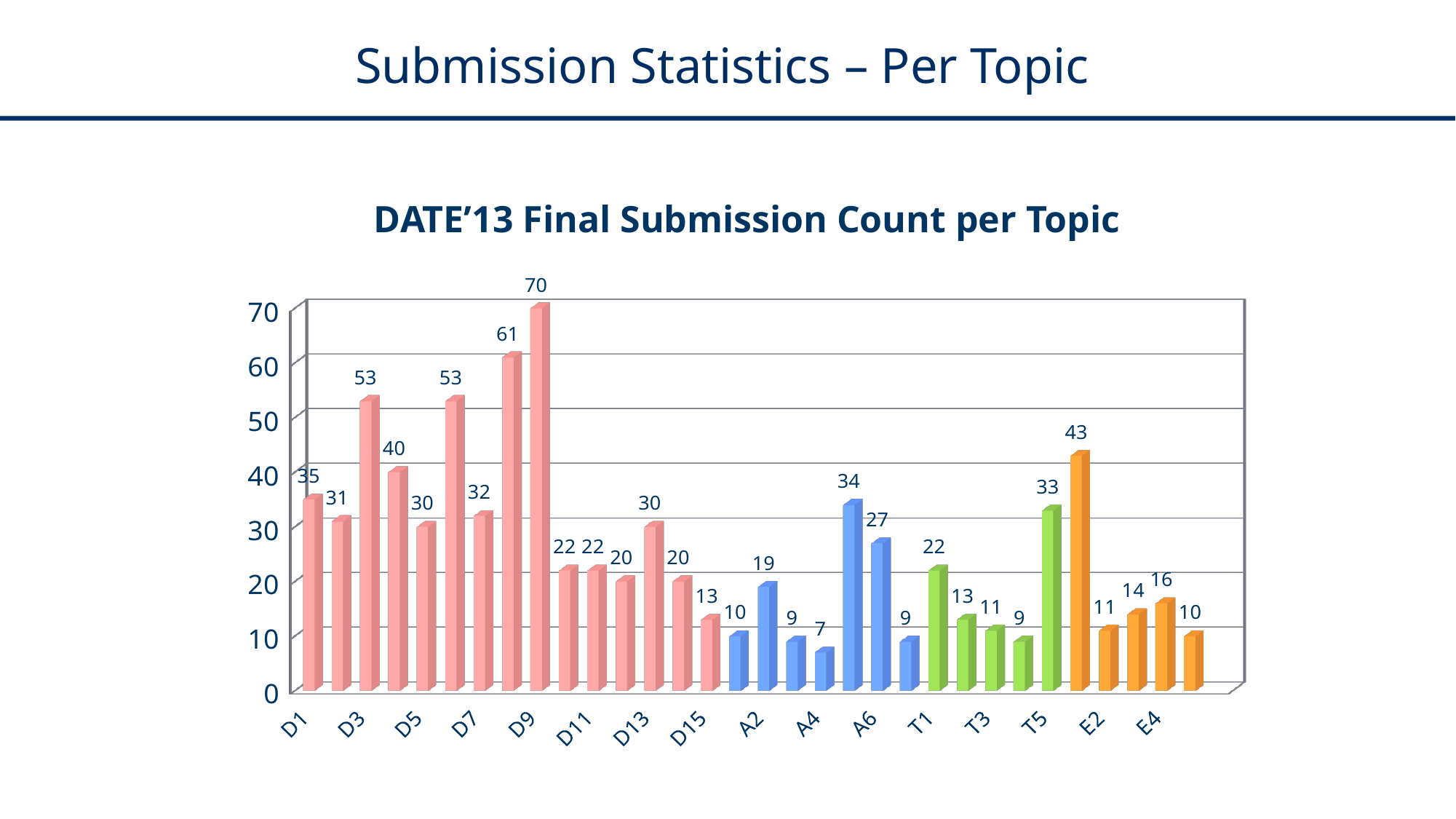
What is the difference between the values for D9 and D3? 17 Is the value for D7 greater or less than 30? greater What is the value for T5? 33 Which topic has the lowest submission count? A4 Which is larger, the value for D1 or the value for T5? D1 What is the difference between the values for T5 and T3? 22 Which topic has the highest submission count? D9 What is the value for D9? 70 What is the title of the chart? DATE'13 Final Submission Count per Topic What is the value for A4? 7 What kind of chart is shown on the slide? bar chart What is the value for E2? 11